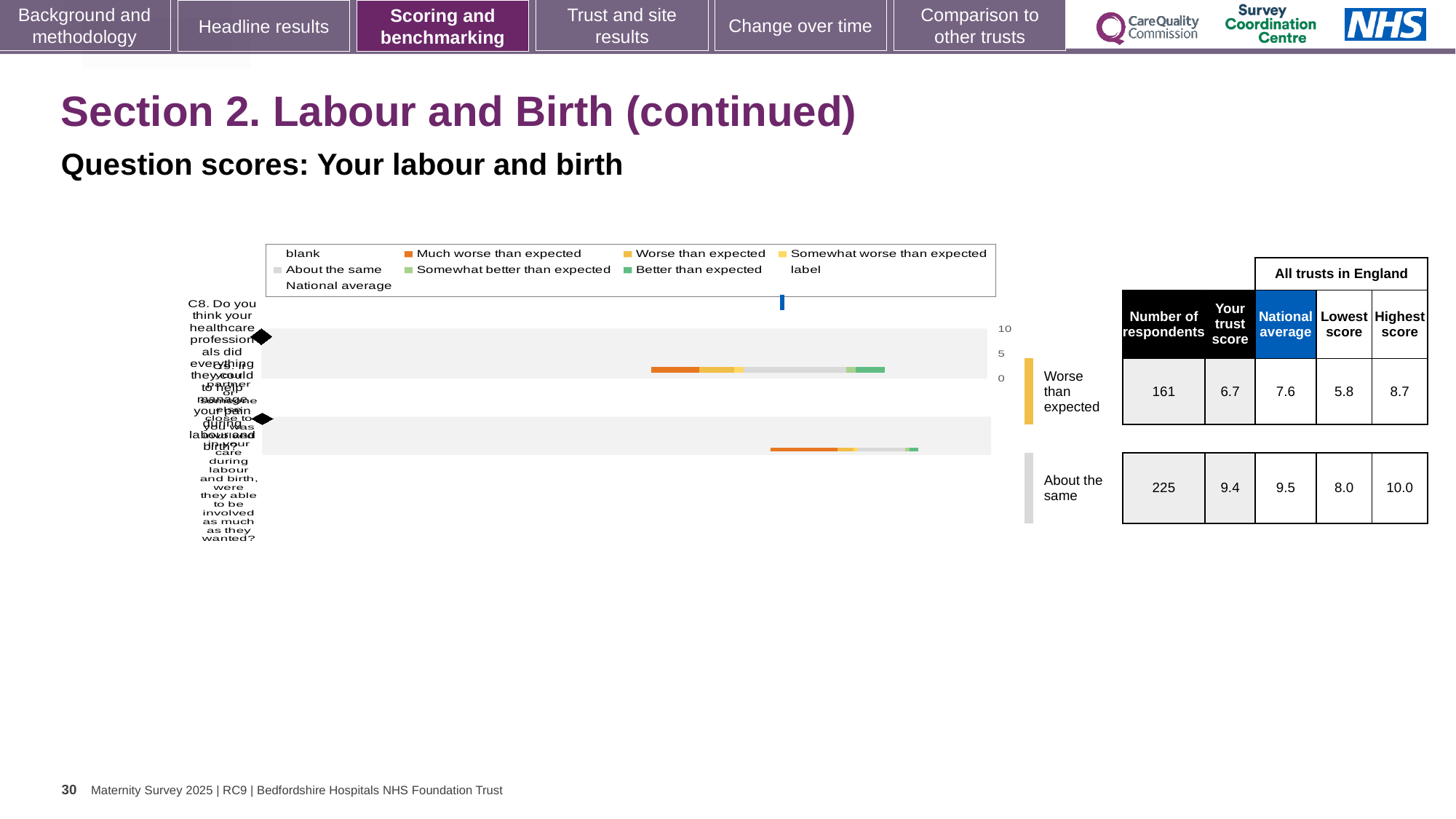
What is the trust score for the question rated 'About the same'? 9.4 What is the difference between the national average and the trust score for the question rated 'Worse than expected'? 0.9 Which question has the higher trust score: the one rated 'Worse than expected' or the one rated 'About the same'? About the same How many question rows are plotted in the chart? 2 What is the national average for the question rated 'Worse than expected'? 7.6 How many respondents answered the question rated 'Worse than expected'? 161 What is the national average for the question rated 'About the same'? 9.5 How many respondents answered the question rated 'About the same'? 225 What is the trust score for the question rated 'Worse than expected'? 6.7 What is the highest score across all trusts in England for the question rated 'About the same'? 10.0 What is the lowest score across all trusts in England for the question rated 'Worse than expected'? 5.8 What kind of chart is shown on the slide? bar chart